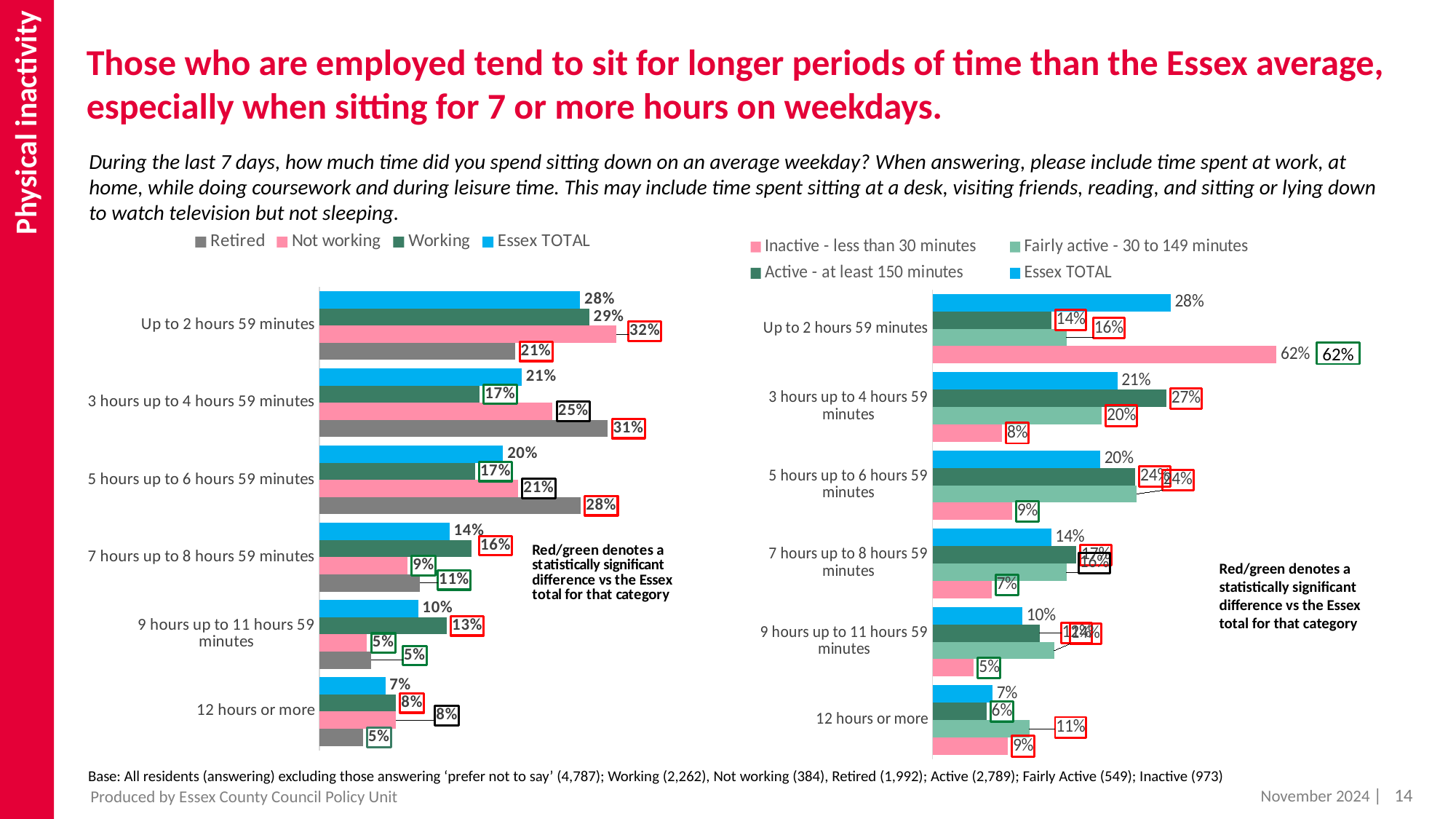
On the left chart, which is larger for '7 hours up to 8 hours 59 minutes': Working or Not working? Working On the left chart, which series has the highest value in the '9 hours up to 11 hours 59 minutes' category? Working On the left chart, what is the difference between the Retired and Essex TOTAL values for '5 hours up to 6 hours 59 minutes'? 8% How many series does the legend of the left chart list? 4 On the left chart, what is the value for Not working in the 'Up to 2 hours 59 minutes' category? 32% How many sitting-time categories are shown on the right chart? 6 What type of chart is the left chart? Bar chart On the right chart, which series has the lowest value in the '5 hours up to 6 hours 59 minutes' category? Inactive - less than 30 minutes On the right chart, what is the value for 'Inactive - less than 30 minutes' in the 'Up to 2 hours 59 minutes' category? 62% On the left chart, what is the value for Retired in the '3 hours up to 4 hours 59 minutes' category? 31% On the right chart, what is the value for 'Active - at least 150 minutes' in the '3 hours up to 4 hours 59 minutes' category? 27% On the right chart, what is the difference between the Inactive and Essex TOTAL values for 'Up to 2 hours 59 minutes'? 34%